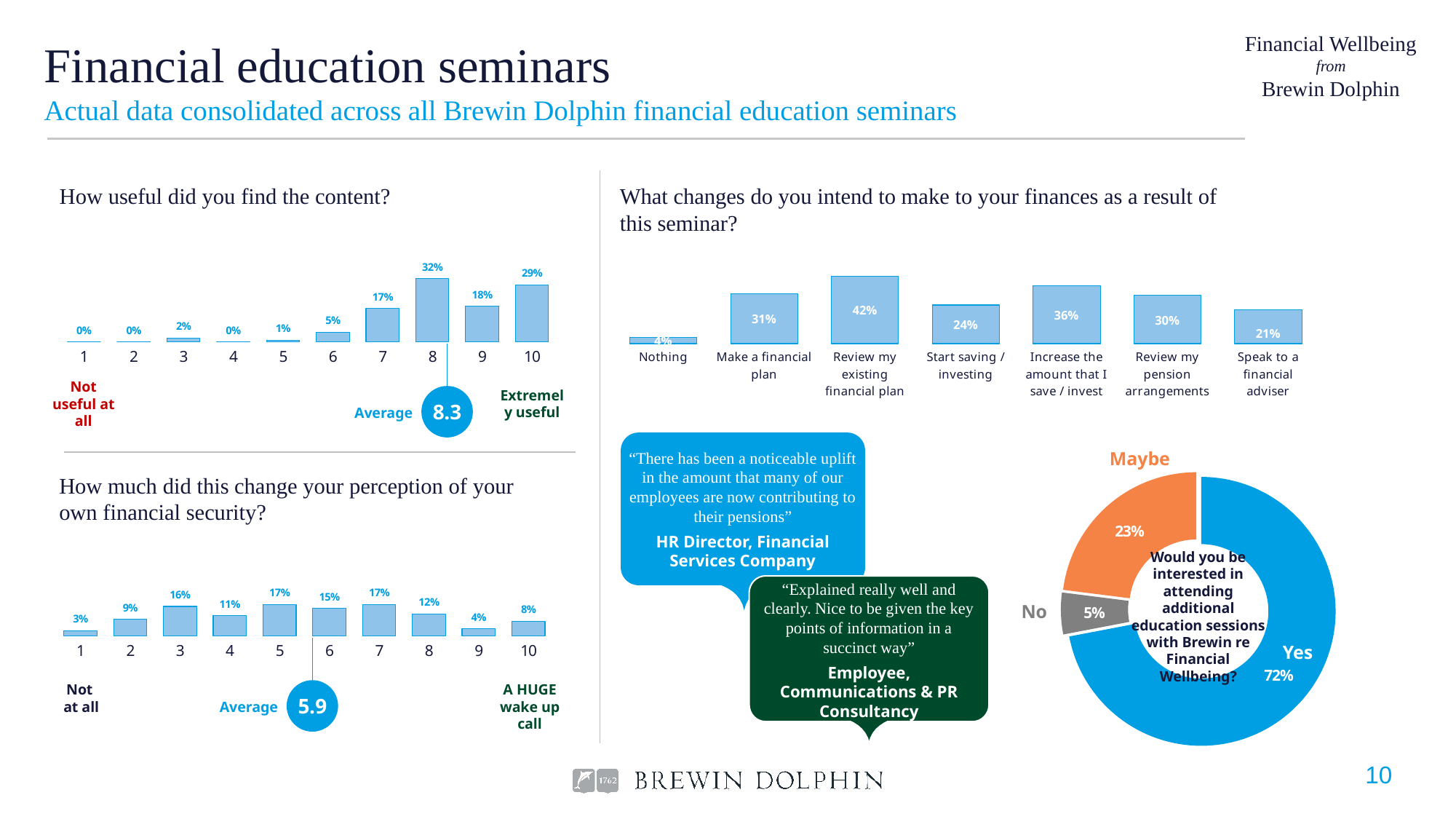
In the 'How useful did you find the content?' chart, what is the difference between the percentages for ratings 8 and 10? 3% In the 'How useful did you find the content?' chart, what percentage of respondents gave a rating of 8? 32% In the 'What changes do you intend to make to your finances as a result of this seminar?' chart, what percentage intend to review their existing financial plan? 42% In the 'How useful did you find the content?' chart, which rating received the highest percentage? 8 In the 'How much did this change your perception of your own financial security?' chart, which rating has the lowest percentage? 1 In the 'What changes do you intend to make to your finances as a result of this seminar?' chart, which option has the lowest percentage? Nothing In the donut chart about interest in attending additional education sessions, what share answered 'Yes'? 72% In the 'What changes do you intend to make to your finances as a result of this seminar?' chart, which is larger: 'Make a financial plan' or 'Start saving / investing'? Make a financial plan What type of chart is used to show whether respondents would be interested in attending additional education sessions? Donut (pie) chart In the 'How useful did you find the content?' chart, what average score is shown? 8.3 In the 'How much did this change your perception of your own financial security?' chart, what percentage gave a rating of 3? 16% In the 'How much did this change your perception of your own financial security?' chart, how many rating categories are shown on the x axis? 10